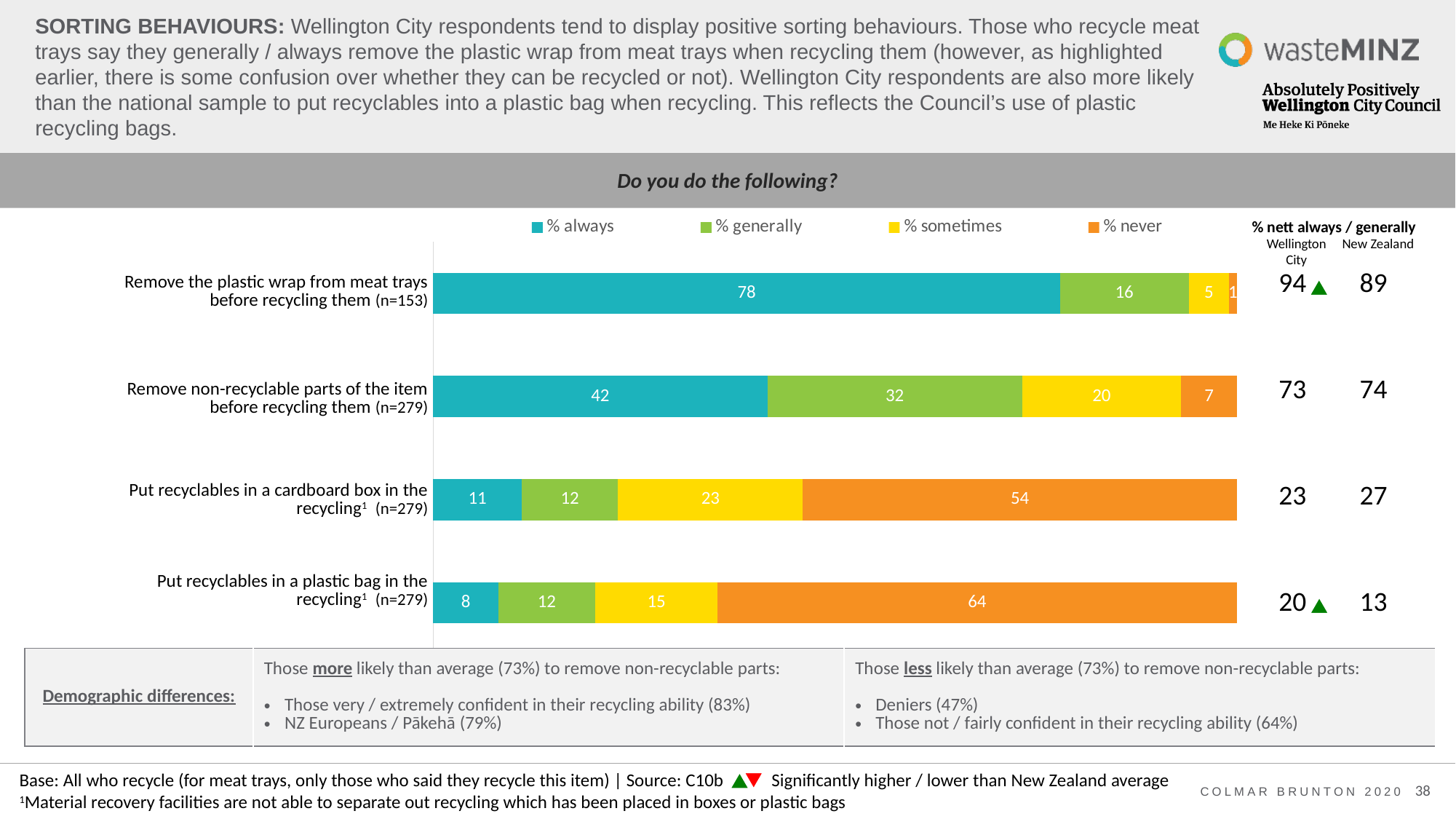
What is the '% nett always / generally' value for Wellington City for 'Put recyclables in a plastic bag in the recycling'? 20 How many series does the chart legend list? 4 Which behaviour has the highest '% always' value? Remove the plastic wrap from meat trays before recycling them What is the '% never' value for 'Put recyclables in a plastic bag in the recycling'? 64 What is the difference between the '% generally' values for 'Remove non-recyclable parts of the item' and 'Remove the plastic wrap from meat trays'? 16 How many behaviours (bars) are shown in the chart? 4 Which behaviour has the lowest '% never' value? Remove the plastic wrap from meat trays before recycling them What is the combined '% always' and '% generally' value for 'Remove non-recyclable parts of the item before recycling them'? 74 What percentage of respondents say they always remove the plastic wrap from meat trays before recycling them? 78 What type of chart is used to show the responses to 'Do you do the following?' Stacked bar chart What is the '% sometimes' value for 'Put recyclables in a cardboard box in the recycling'? 23 Which has a larger '% never' value: 'Put recyclables in a cardboard box' or 'Put recyclables in a plastic bag'? Put recyclables in a plastic bag in the recycling